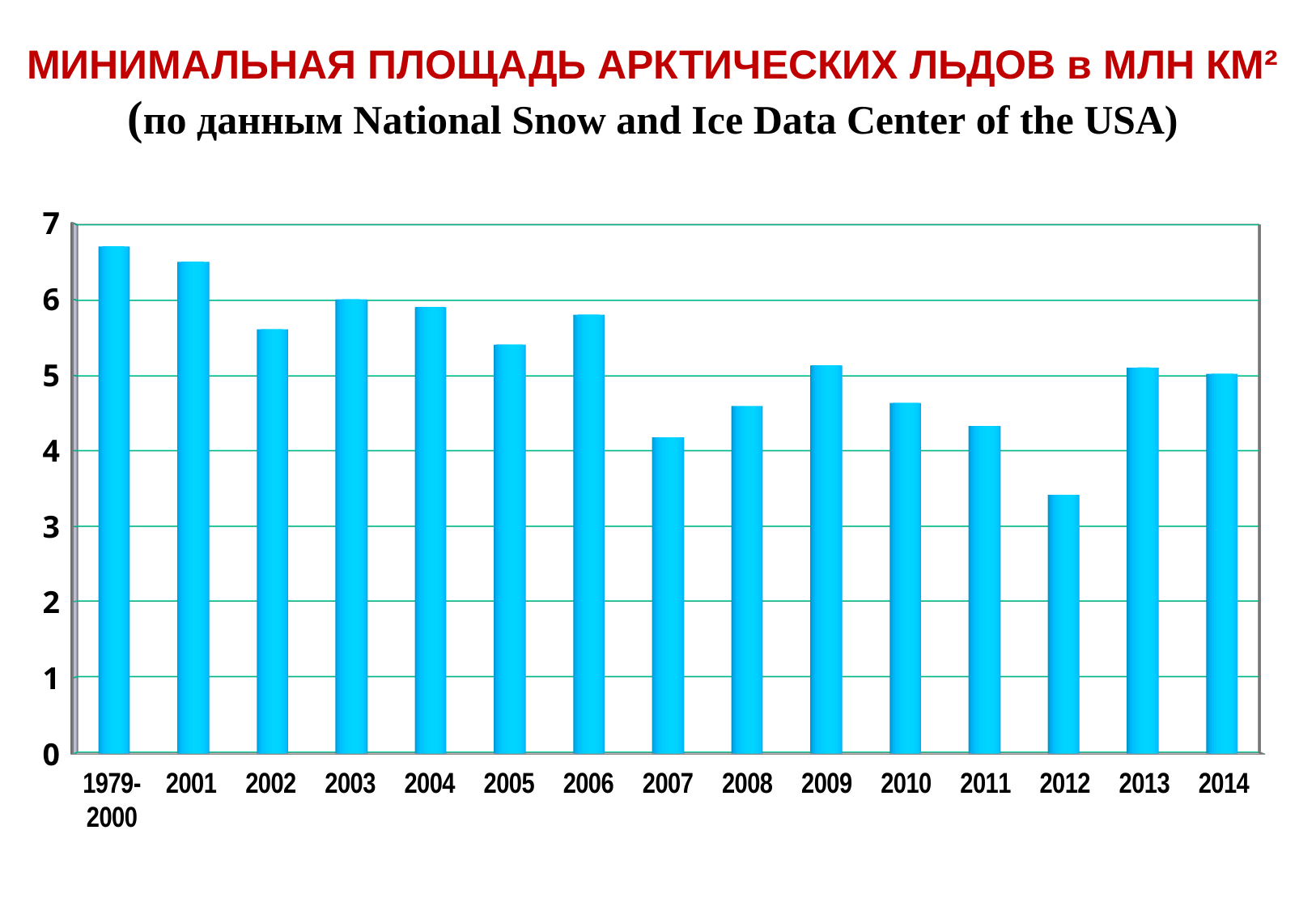
Do the values generally rise or fall from 1979-2000 to 2012 along the x axis? fall What kind of chart is shown on the slide? bar chart Is the value for 2001 greater or less than 6? greater Is the value for 2002 greater or less than 6? less Is the value for 2012 greater or less than 4? less How many categories (bars) are plotted on the chart? 15 Which is larger, the value for 2001 or the value for 2002? 2001 Which is larger, the value for 2007 or the value for 2012? 2007 Which year has the lowest value on the chart? 2012 Which category has the highest value on the chart? 1979-2000